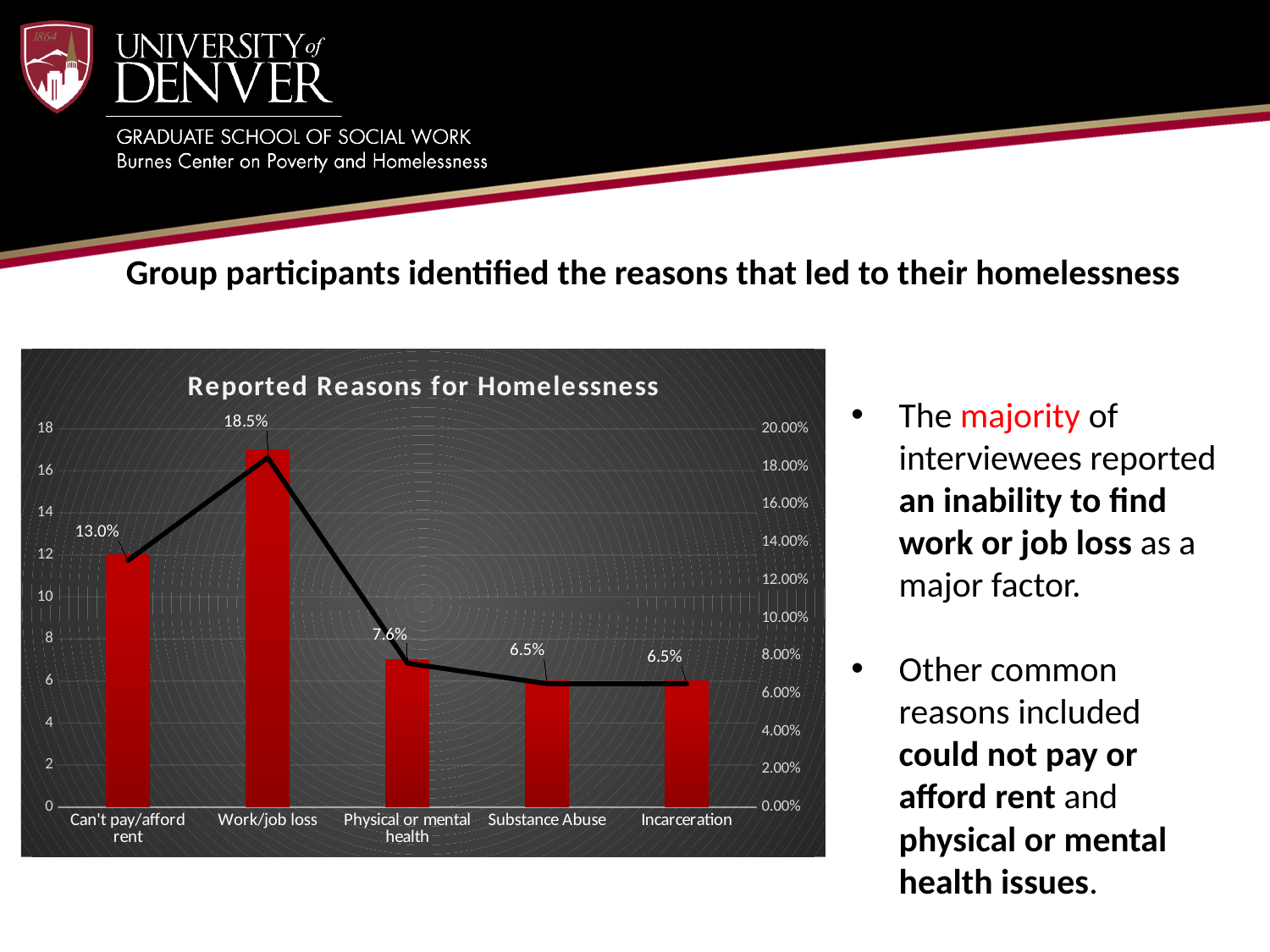
What is the difference between the labelled percentages for Can't pay/afford rent and Physical or mental health? 5.4% How many reason categories are shown on the x axis of the Reported Reasons for Homelessness chart? 5 What percentage is labelled for Can't pay/afford rent in the Reported Reasons for Homelessness chart? 13.0% Do the values rise or fall from Work/job loss to Physical or mental health in the Reported Reasons for Homelessness chart? fall What is the title of the chart on the slide? Reported Reasons for Homelessness What percentage is labelled for Physical or mental health in the Reported Reasons for Homelessness chart? 7.6% Which has a larger value, Can't pay/afford rent or Physical or mental health? Can't pay/afford rent What percentage is labelled for Work/job loss in the Reported Reasons for Homelessness chart? 18.5% On the left axis, is the bar for Work/job loss greater or less than 16? greater Which reason has the highest value in the Reported Reasons for Homelessness chart? Work/job loss What is the difference between the labelled percentages for Work/job loss and Can't pay/afford rent? 5.5% What percentage is labelled for Incarceration in the Reported Reasons for Homelessness chart? 6.5%